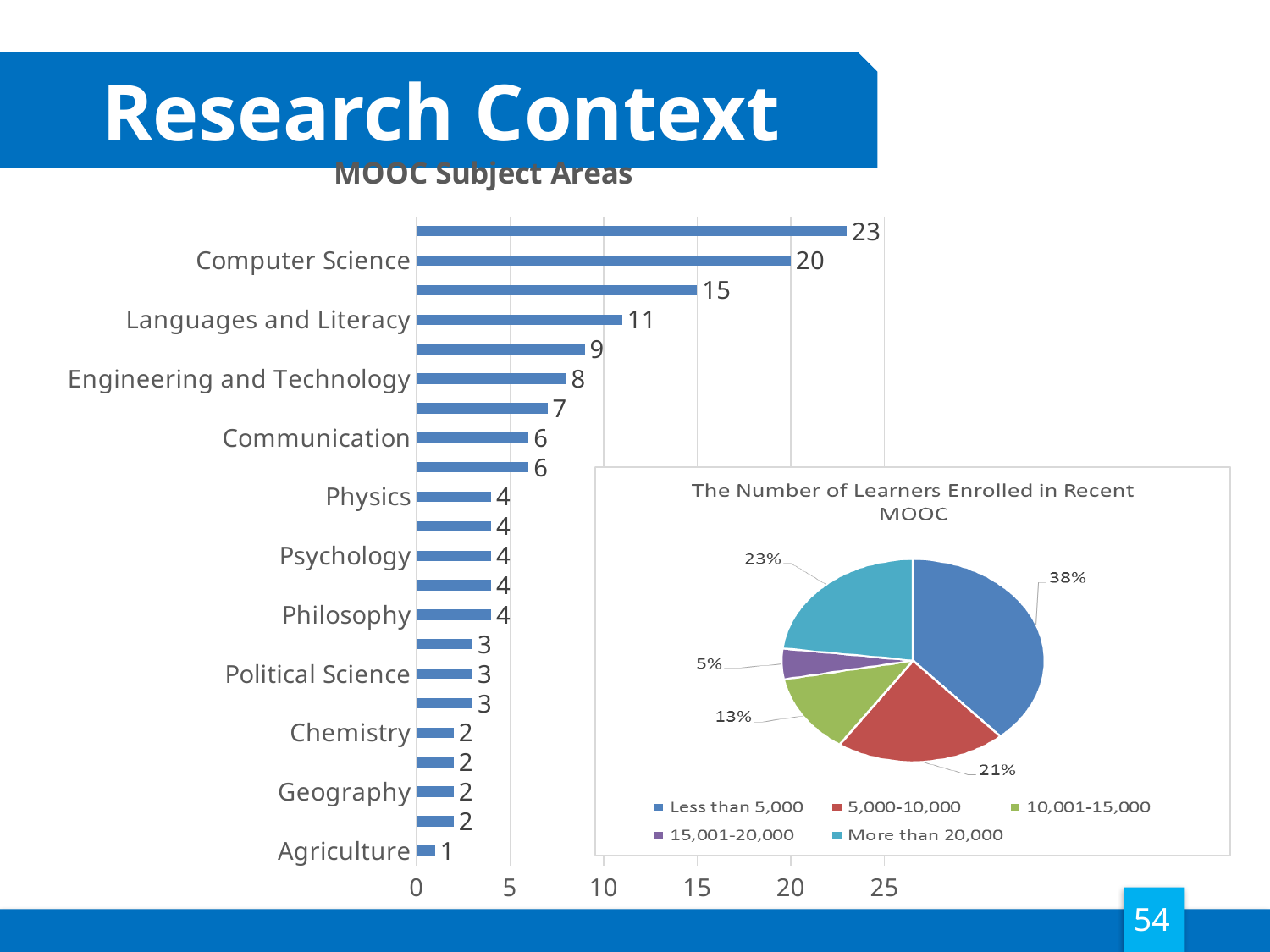
In the MOOC Subject Areas bar chart, what is the value for Agriculture? 1 How many categories does the legend of the pie chart titled The Number of Learners Enrolled in Recent MOOC list? 5 In the pie chart titled The Number of Learners Enrolled in Recent MOOC, what share is Less than 5,000? 38% In the MOOC Subject Areas bar chart, which labelled category has the lowest value? Agriculture In the pie chart titled The Number of Learners Enrolled in Recent MOOC, which category has the largest share? Less than 5,000 In the MOOC Subject Areas bar chart, what is the value for Engineering and Technology? 8 In the MOOC Subject Areas bar chart, what is the value for Computer Science? 20 What kind of chart is the MOOC Subject Areas chart? Bar chart In the MOOC Subject Areas bar chart, what is the difference between the values for Computer Science and Communication? 14 In the MOOC Subject Areas bar chart, what is the value for Languages and Literacy? 11 In the MOOC Subject Areas bar chart, which is larger, the value for Political Science or the value for Chemistry? Political Science In the pie chart titled The Number of Learners Enrolled in Recent MOOC, what share is 15,001-20,000? 5%